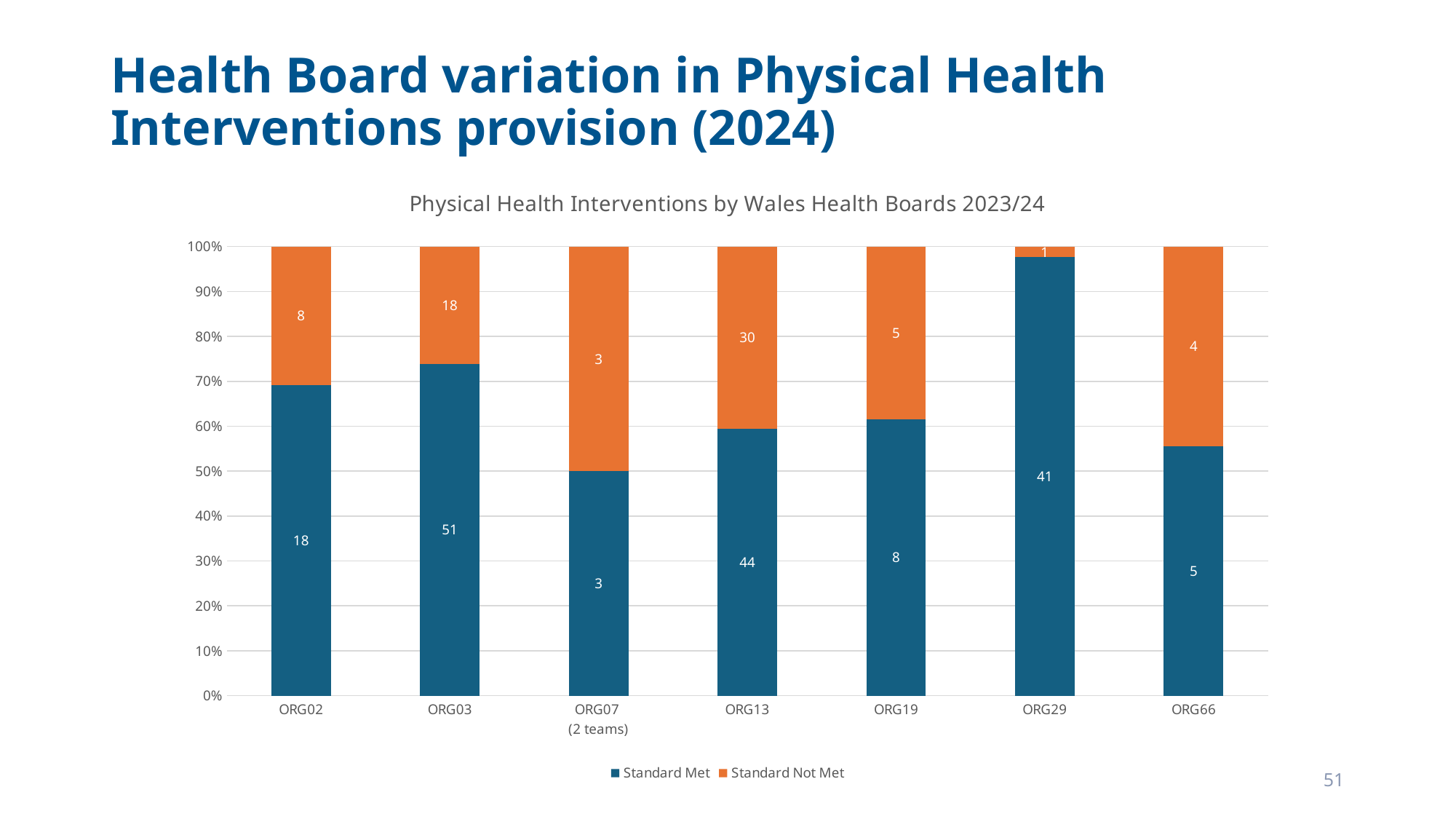
Which health board has the lowest Standard Not Met value? ORG29 What is the Standard Not Met value for ORG13? 30 Which is larger for ORG66: the Standard Met value or the Standard Not Met value? Standard Met How many health boards are shown on the x axis? 7 Is the Standard Met share for ORG29 greater or less than 90%? greater What is the Standard Met value for ORG03? 51 How many series does the legend list? 2 What is the difference between the Standard Met and Standard Not Met values for ORG02? 10 What kind of chart is shown on the slide? Stacked bar chart What is the Standard Not Met value for ORG29? 1 What is the total of the Standard Met and Standard Not Met values for ORG13? 74